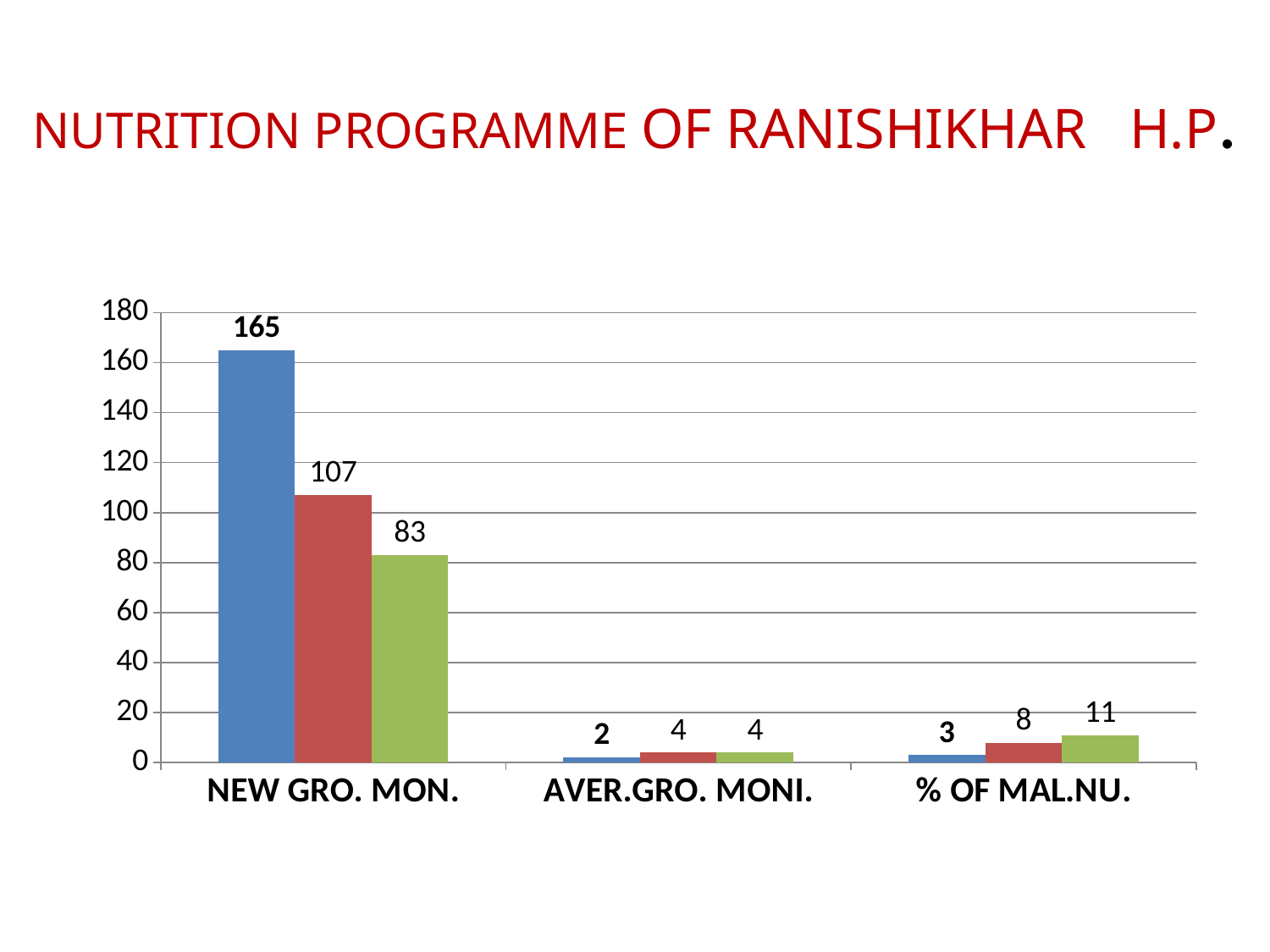
What is the value of the blue bar for NEW GRO. MON.? 165 For % OF MAL.NU., which is larger, the red bar or the green bar? green bar What is the value of the green bar for % OF MAL.NU.? 11 What is the value of the blue bar for AVER.GRO. MONI.? 2 How many categories are shown on the x axis of the chart? 3 What is the title of the slide containing the chart? NUTRITION PROGRAMME OF RANISHIKHAR H.P. What is the value of the red bar for NEW GRO. MON.? 107 Is the value of the red bar for NEW GRO. MON. greater or less than 100? greater What kind of chart is shown on the slide? bar chart What is the difference between the blue bar and the green bar for NEW GRO. MON.? 82 Which category has the lowest green bar? AVER.GRO. MONI. Which category has the highest blue bar? NEW GRO. MON.